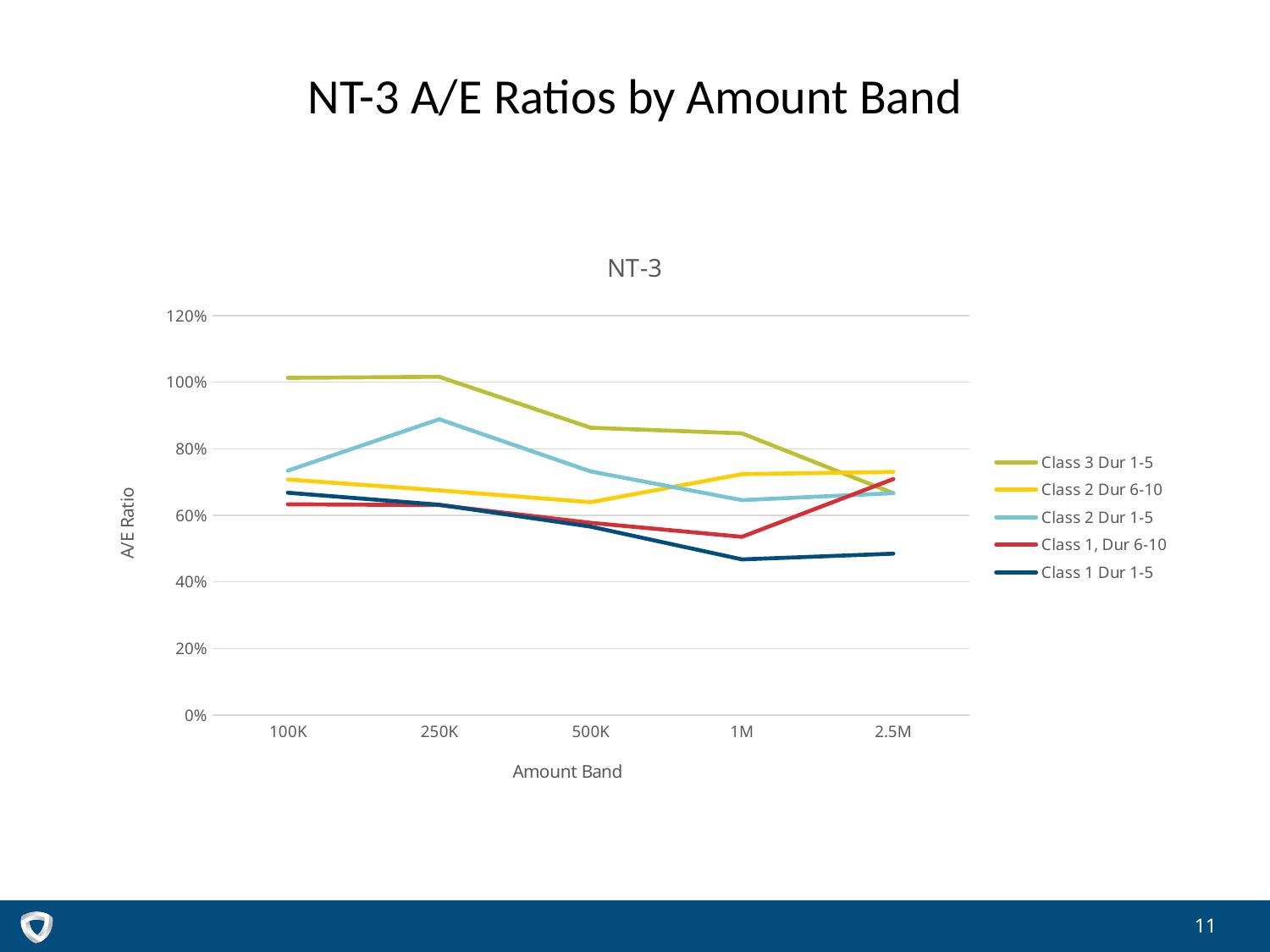
Is the value for Class 2 Dur 1-5 at the 250K amount band greater or less than 80%? greater How many amount bands are shown on the x axis? 5 Does the Class 1 Dur 1-5 line rise or fall from 100K to 1M? Fall At the 100K amount band, which is larger: Class 2 Dur 1-5 or Class 1, Dur 6-10? Class 2 Dur 1-5 How many series does the legend list? 5 What type of chart is shown on the slide? Line chart Is the value for Class 1 Dur 1-5 at the 1M amount band greater or less than 60%? less Is the value for Class 3 Dur 1-5 at the 500K amount band greater or less than 80%? greater Which series has the lowest A/E ratio at the 1M amount band? Class 1 Dur 1-5 Which series has the highest A/E ratio at the 250K amount band? Class 3 Dur 1-5 At the 2.5M amount band, which is larger: Class 1, Dur 6-10 or Class 1 Dur 1-5? Class 1, Dur 6-10 What is the title of the vertical axis? A/E Ratio